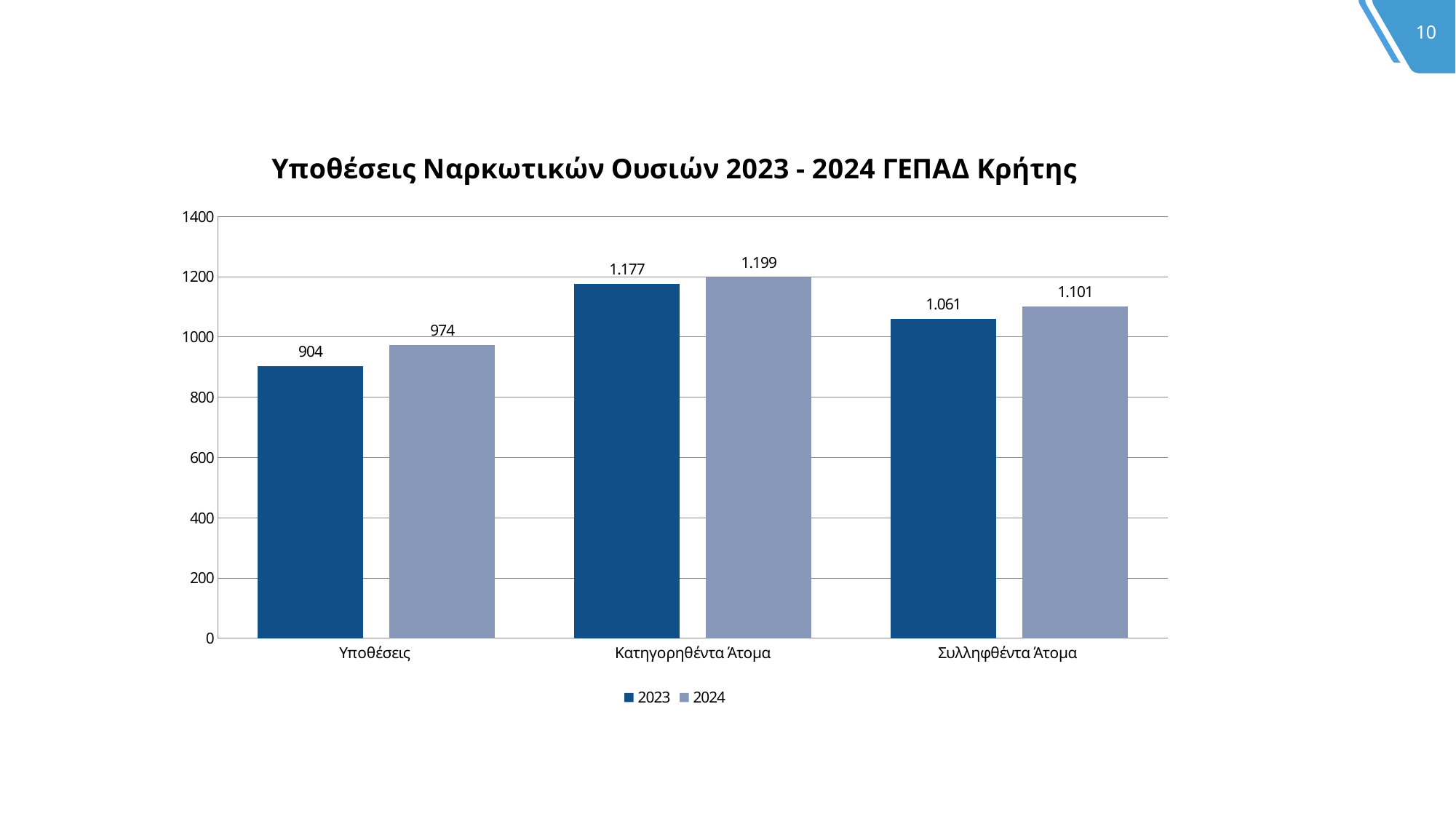
What is the value for Συλληφθέντα Άτομα in 2023? 1.061 What is the difference between the 2024 and 2023 values for Συλληφθέντα Άτομα? 40 What is the difference between the 2024 and 2023 values for Υποθέσεις? 70 How many categories are shown on the x axis? 3 What kind of chart is shown on the slide? bar chart Which category has the highest value in the 2024 series? Κατηγορηθέντα Άτομα How many series does the legend list? 2 Which is larger for Κατηγορηθέντα Άτομα, the 2023 value or the 2024 value? 2024 What is the value for Υποθέσεις in 2023? 904 Is the 2023 value for Υποθέσεις greater or less than 1000? less Which category has the lowest value in the 2023 series? Υποθέσεις What is the value for Κατηγορηθέντα Άτομα in 2024? 1.199